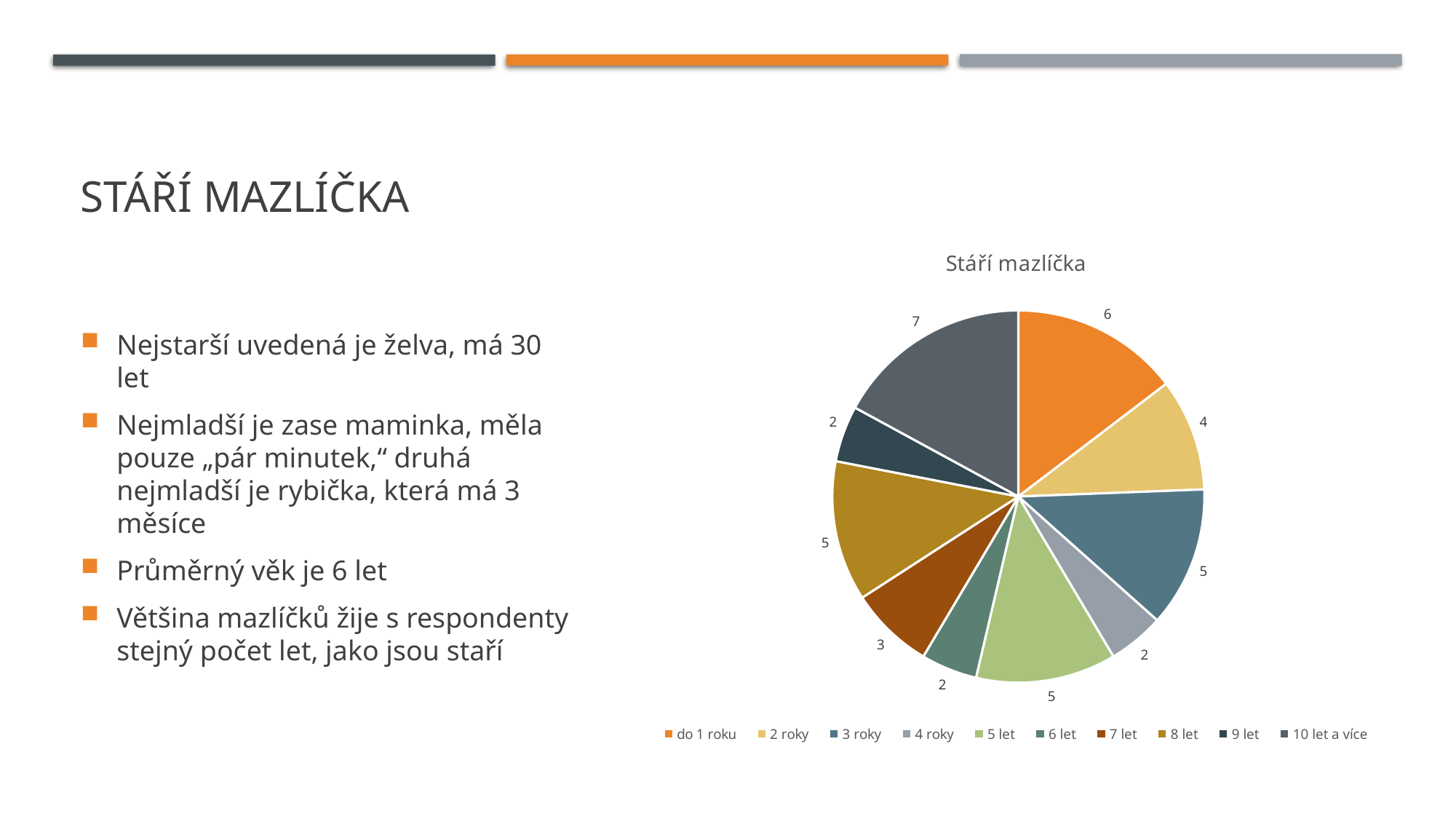
How many entries does the legend list? 10 Which category has the largest slice in the pie chart? 10 let a více What is the value for the '2 roky' slice? 4 How many slices does the pie chart have? 10 What is the value for the 'do 1 roku' slice? 6 What is the value for the '7 let' slice? 3 What is the difference between the values for '3 roky' and '4 roky'? 3 What is the difference between the values for '10 let a více' and 'do 1 roku'? 1 What is the title of the chart? Stáří mazlíčka What is the value for the '10 let a více' slice? 7 Which is larger, the value for '2 roky' or the value for '8 let'? 8 let What type of chart is shown on the slide? pie chart